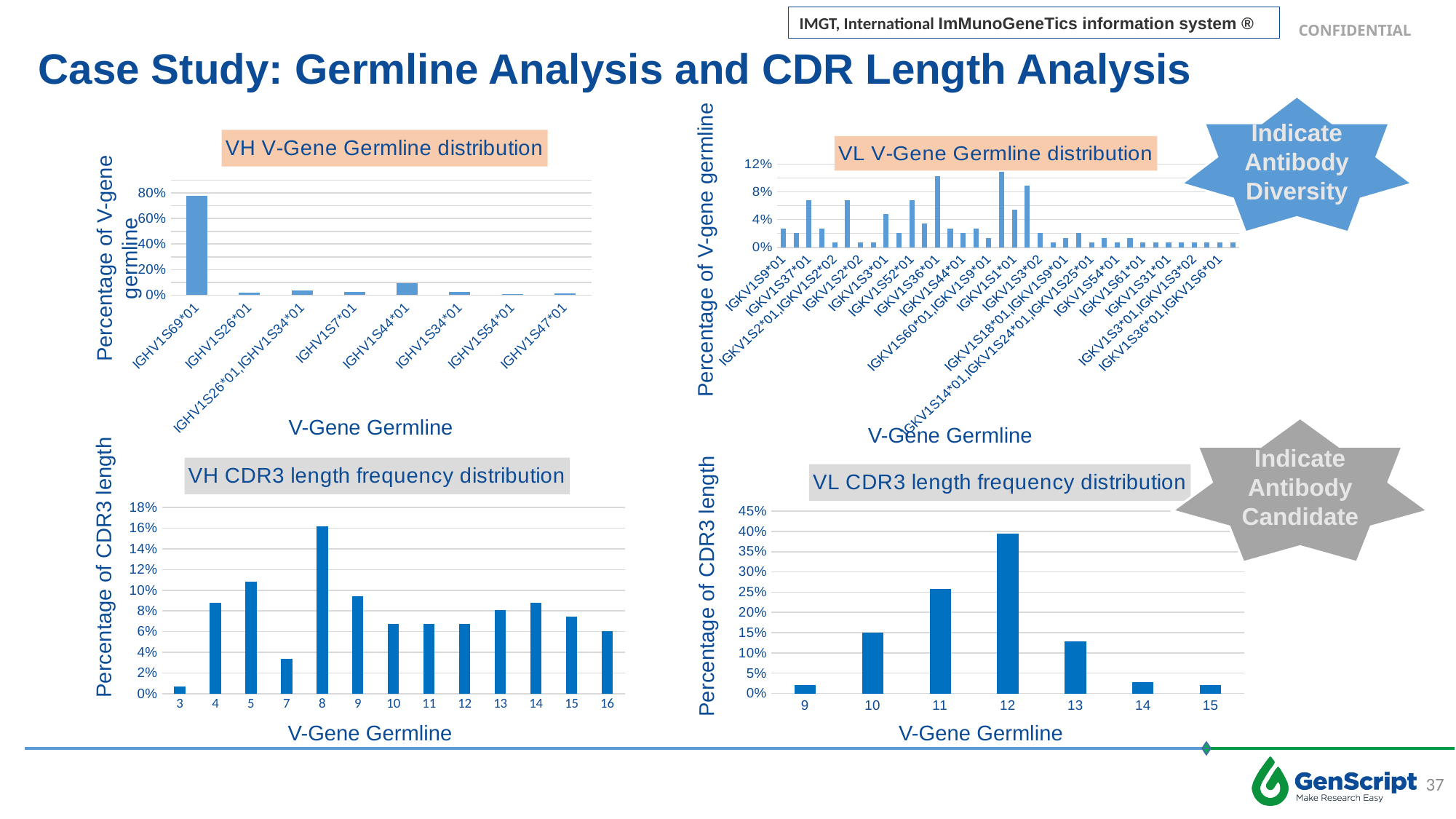
In the VH V-Gene Germline distribution chart, is the value for IGHV1S69*01 greater or less than 60%? greater In the VH CDR3 length frequency distribution chart, is the value for length 7 greater or less than 4%? less In the VH CDR3 length frequency distribution chart, which CDR3 length has the highest percentage? 8 In the VH CDR3 length frequency distribution chart, how many CDR3 length categories are shown on the x axis? 13 What kind of chart is the VL CDR3 length frequency distribution chart? bar chart In the VL CDR3 length frequency distribution chart, which is larger, the value for length 11 or the value for length 13? length 11 In the VH CDR3 length frequency distribution chart, is the value for length 8 greater or less than 14%? greater In the VH V-Gene Germline distribution chart, which germline has the highest percentage? IGHV1S69*01 In the VH CDR3 length frequency distribution chart, which CDR3 length has the lowest percentage? 3 In the VL CDR3 length frequency distribution chart, which CDR3 length has the highest percentage? 12 In the VH V-Gene Germline distribution chart, how many germline categories are shown on the x axis? 8